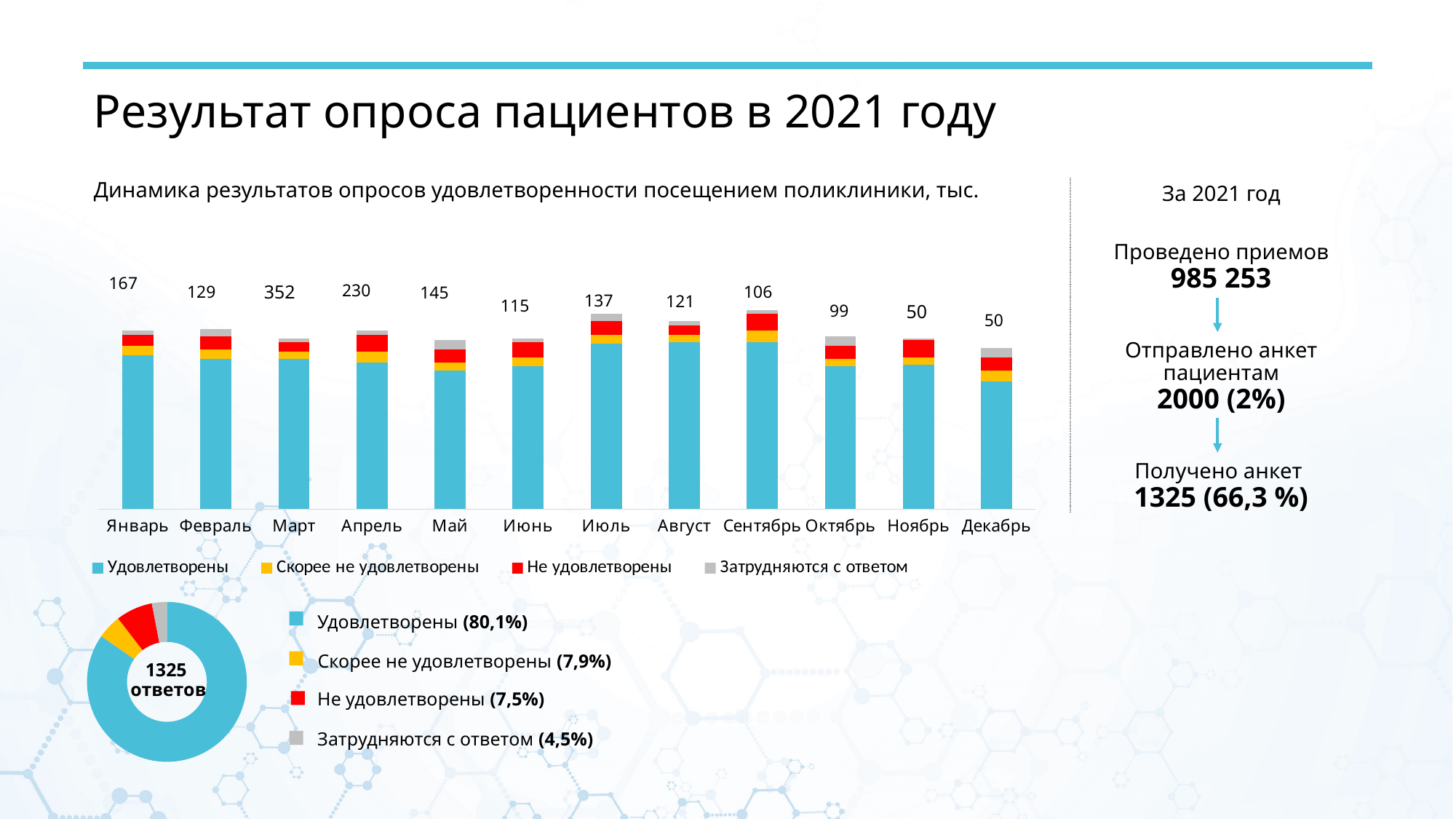
How many series does the legend of the bar chart list? 4 In the bar chart, what is the difference between the numbers printed above the bars for Март and Апрель? 122 In the bar chart, what number is printed above the bar for Январь? 167 In the bar chart, which month has the highest number printed above its bar? Март How many months are shown on the x axis of the bar chart? 12 In the donut chart, what share is shown for Затрудняются с ответом? 4,5% In the bar chart, what number is printed above the bar for Сентябрь? 106 In the donut chart, what share is shown for Удовлетворены? 80,1% In the bar chart, which has the larger number printed above its bar, Январь or Февраль? Январь What kind of chart is the chart showing monthly results? Stacked bar chart What number of responses is printed in the centre of the donut chart? 1325 ответов In the bar chart, what number is printed above the bar for Март? 352